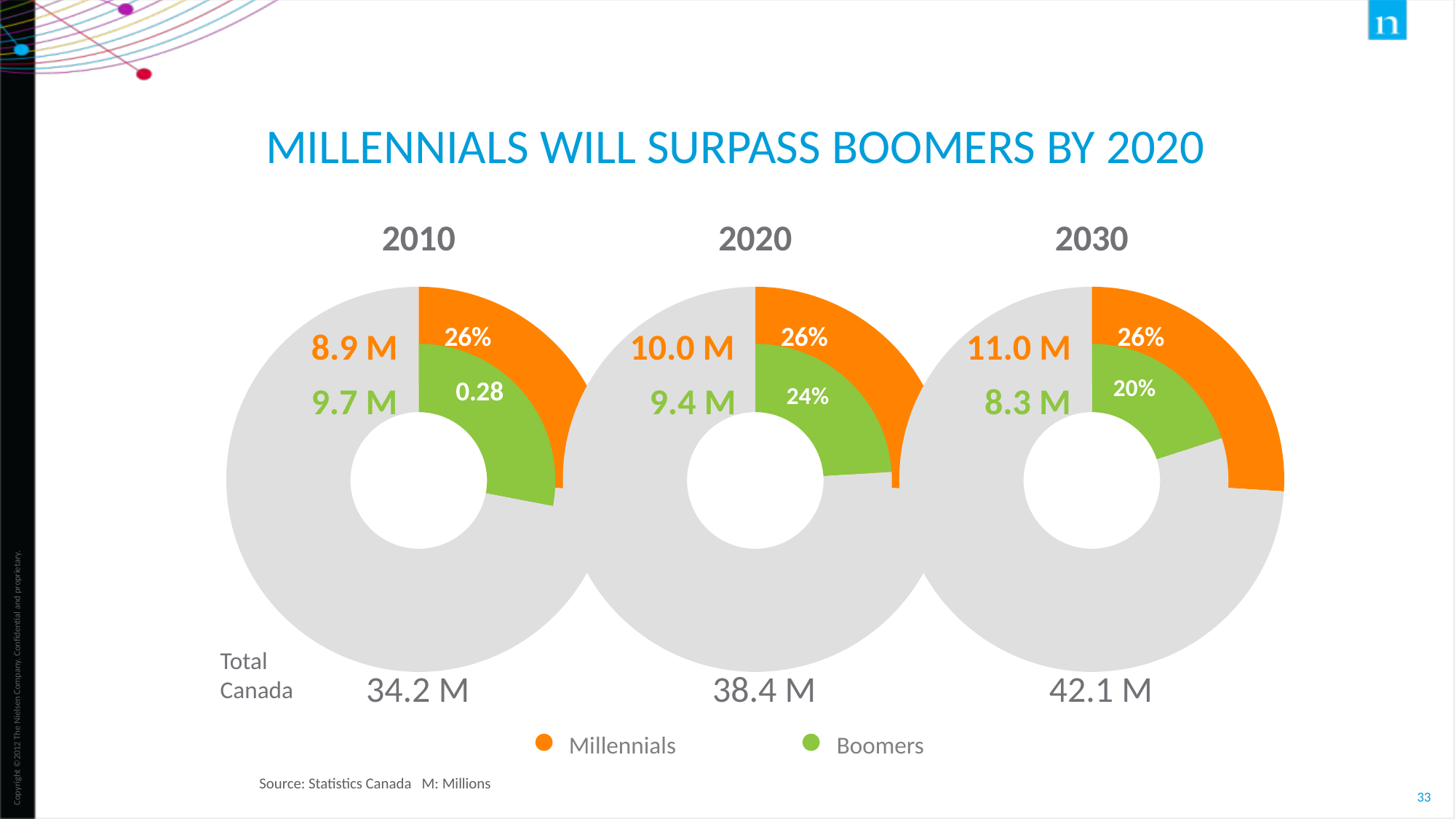
In the 2020 chart, which is larger, Millennials or Boomers? Millennials In the 2020 chart, what percentage label is shown on the Millennials slice? 26% In the 2010 chart, which is larger, Millennials or Boomers? Boomers In the 2010 chart, what is the value shown for Boomers? 9.7 M How many series does the legend list? 2 In the 2030 chart, what is the value shown for Boomers? 8.3 M In the 2020 chart, what is the value shown for Millennials? 10.0 M What kind of chart is used to show the 2010, 2020 and 2030 data? Donut (pie) chart In the 2030 chart, what is the difference between the Millennials value and the Boomers value? 2.7 M In the 2030 chart, what percentage label is shown on the Boomers slice? 20% In the 2010 chart, what is the value shown for Millennials? 8.9 M What is the Total Canada value shown under the 2030 chart? 42.1 M